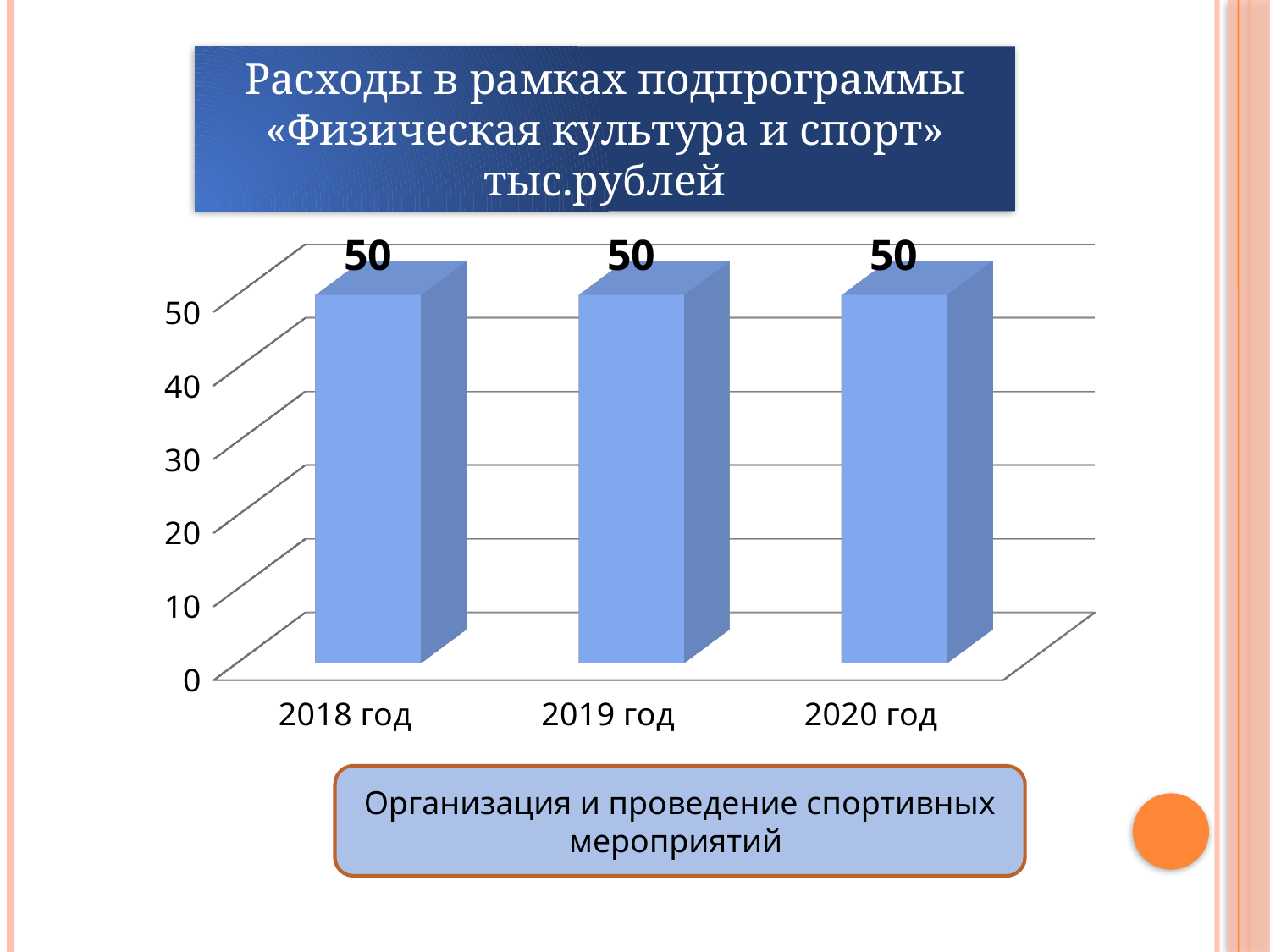
What is the value for 2018 год? 50 What is the value for 2020 год? 50 What is the difference between the values for 2018 год and 2020 год? 0 How many categories (years) are shown on the x axis? 3 Is the value for 2019 год greater or less than 40? greater What is the highest value shown on the vertical axis? 50 What is the value for 2019 год? 50 What is the total of the values for 2018 год, 2019 год and 2020 год? 150 Do the values rise, fall, or stay the same from 2018 год to 2020 год? stay the same In what units are the expenses in the chart title expressed? тыс.рублей What kind of chart is shown on the slide? bar chart